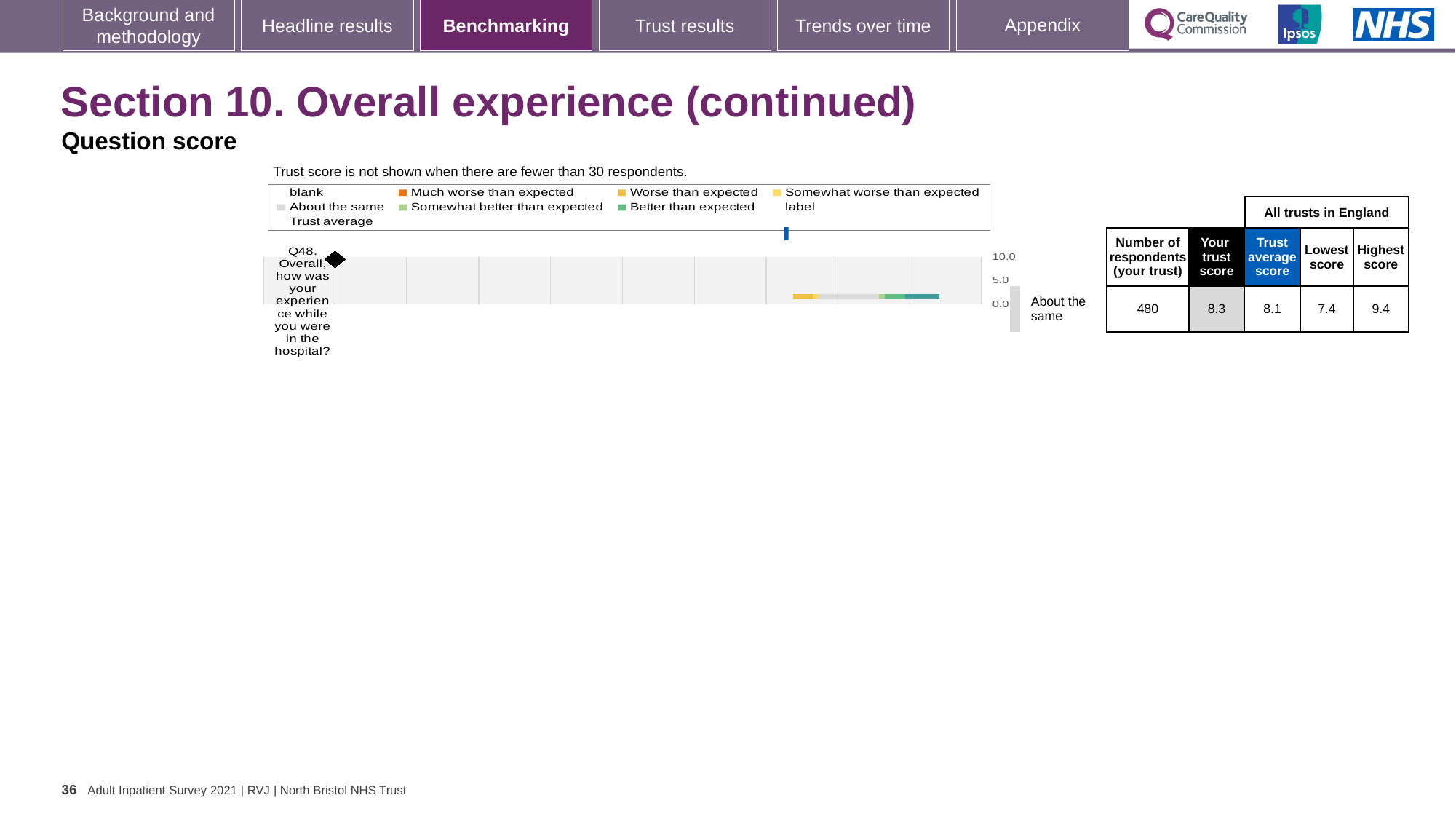
What is the maximum value shown on the chart's score axis? 10.0 What is the trust average score for Q48 across all trusts in England? 8.1 Which is larger for Q48: your trust score or the trust average score? Your trust score What is the highest score among all trusts in England for Q48? 9.4 What kind of chart is used to show the Q48 question score? Bar chart What is the difference between the highest and lowest scores among all trusts in England for Q48? 2.0 What is the difference between your trust score and the trust average score for Q48? 0.2 What benchmark rating is given to the trust for Q48 on this chart? About the same What is the lowest score among all trusts in England for Q48? 7.4 What is the trust score for Q48 (Overall, how was your experience while you were in the hospital?) shown in the table next to the chart? 8.3 How many survey questions are plotted on the chart? 1 How many respondents from the trust answered Q48? 480